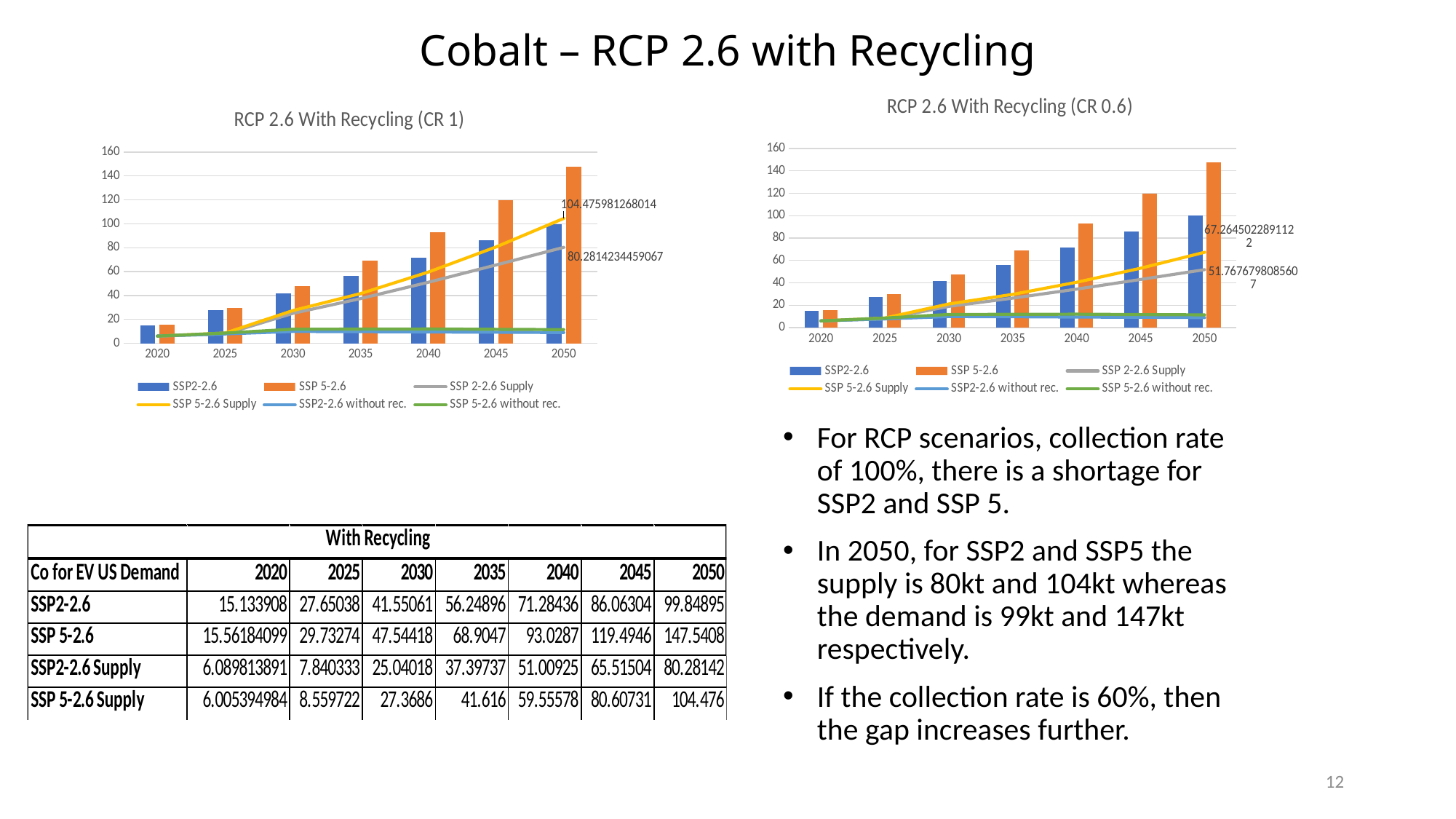
In the left chart 'RCP 2.6 With Recycling (CR 1)', which year has the highest SSP 5-2.6 bar? 2050 In the left chart 'RCP 2.6 With Recycling (CR 1)', is the SSP 5-2.6 bar for 2050 greater or less than 140? greater In the left chart 'RCP 2.6 With Recycling (CR 1)', what is the labelled value of SSP 2-2.6 Supply in 2050? 80.2814234459067 In the right chart 'RCP 2.6 With Recycling (CR 0.6)', what is the labelled value of SSP 2-2.6 Supply in 2050? 51.7676798085607 In the right chart 'RCP 2.6 With Recycling (CR 0.6)', what is the labelled value of SSP 5-2.6 Supply in 2050? 67.2645022891122 In the right chart 'RCP 2.6 With Recycling (CR 0.6)', how many years are shown on the x axis? 7 In the left chart 'RCP 2.6 With Recycling (CR 1)', what is the difference between the 2050 SSP 5-2.6 Supply and SSP 2-2.6 Supply labelled values? 24.1945578221073 What kind of chart is the left chart titled 'RCP 2.6 With Recycling (CR 1)'? Bar chart with line series In the left chart 'RCP 2.6 With Recycling (CR 1)', what is the labelled value of SSP 5-2.6 Supply in 2050? 104.475981268014 In the left chart 'RCP 2.6 With Recycling (CR 1)', how many series does the legend list? 6 In the right chart 'RCP 2.6 With Recycling (CR 0.6)', is the SSP2-2.6 bar for 2050 greater or less than 80? greater In the right chart 'RCP 2.6 With Recycling (CR 0.6)', do the SSP2-2.6 bars rise or fall from 2020 to 2050? rise